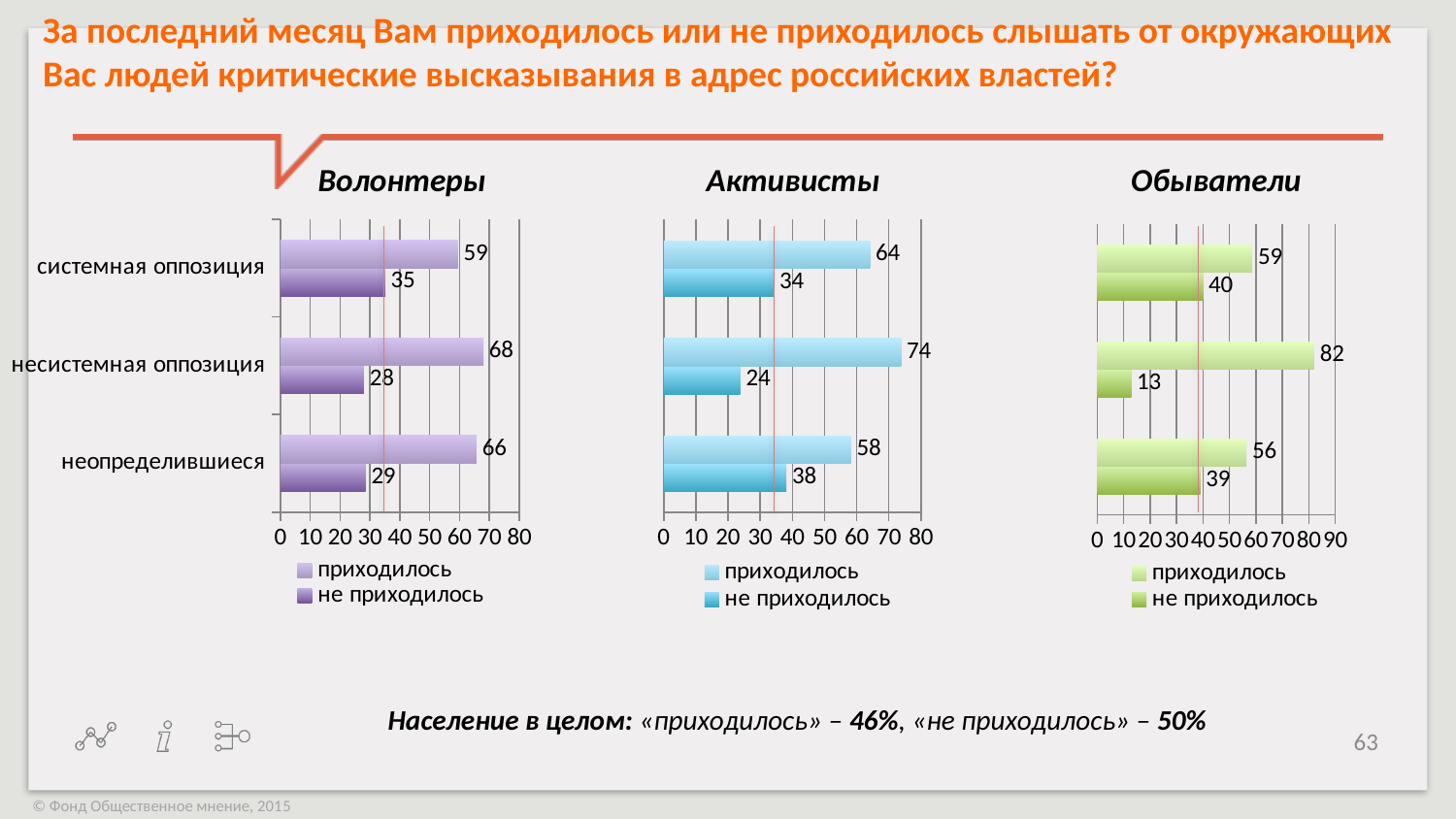
In the 'Обыватели' chart, which category has the lowest value for 'не приходилось'? несистемная оппозиция In the 'Волонтеры' chart, what is the value of 'приходилось' for 'несистемная оппозиция'? 68 What type of chart is the 'Активисты' chart? bar chart How many series does the legend of the 'Обыватели' chart list? 2 In the 'Активисты' chart, which category has the highest value for 'приходилось'? несистемная оппозиция In the 'Обыватели' chart, what is the value of 'приходилось' for 'несистемная оппозиция'? 82 In the 'Обыватели' chart, what is the total of 'приходилось' and 'не приходилось' for 'неопределившиеся'? 95 In the 'Активисты' chart, which is larger for 'системная оппозиция': 'приходилось' or 'не приходилось'? приходилось How many categories are shown in the 'Волонтеры' chart? 3 What are the titles of the three charts on the slide, from left to right? Волонтеры, Активисты, Обыватели In the 'Волонтеры' chart, what is the difference between 'приходилось' and 'не приходилось' for 'системная оппозиция'? 24 In the 'Активисты' chart, what is the value of 'не приходилось' for 'неопределившиеся'? 38